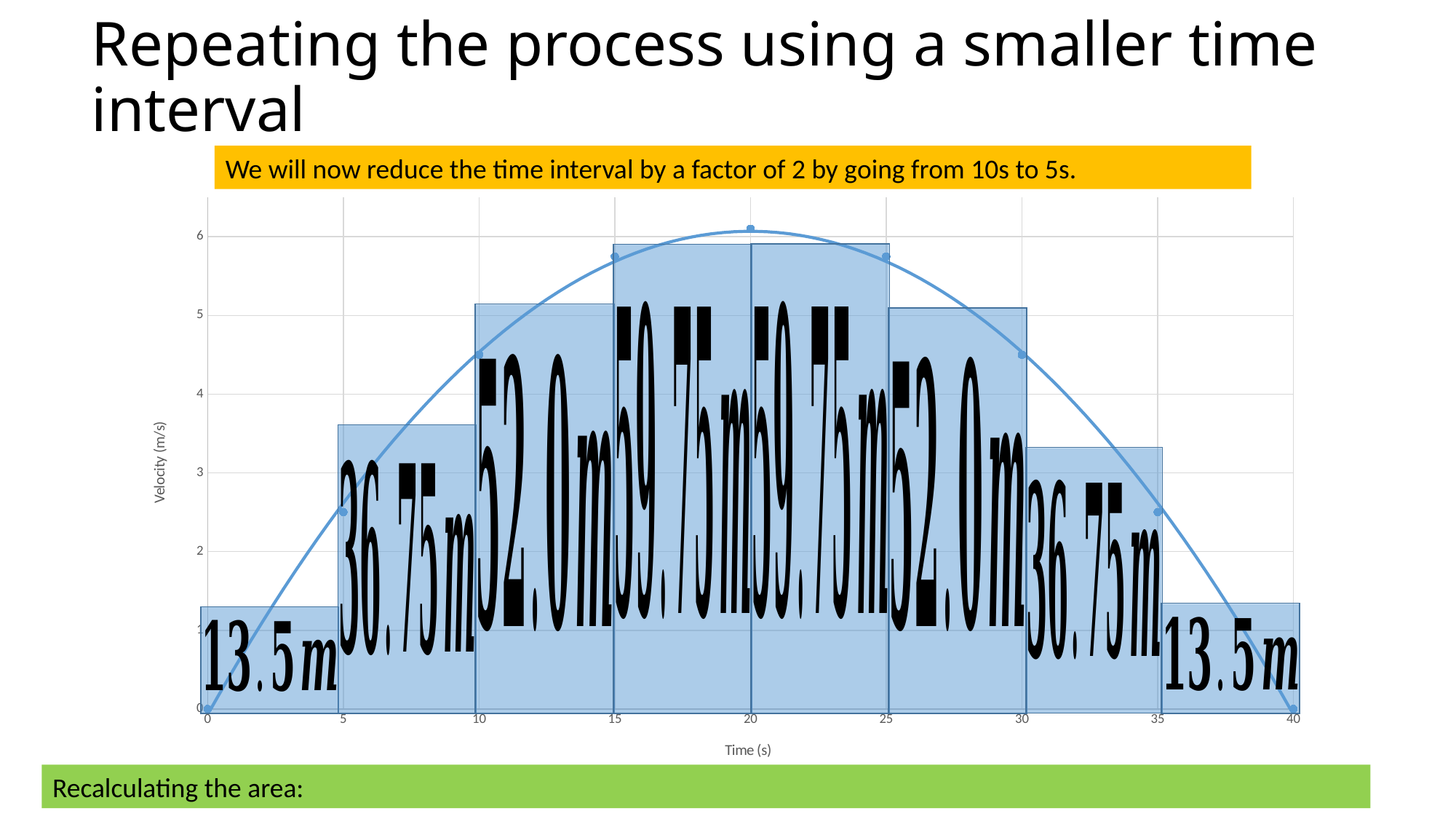
What area value is printed on the rectangle between 30 s and 35 s? 36.75m What is the difference between the area printed on the 15–20 s rectangle and the area printed on the 0–5 s rectangle? 46.25m What area value is printed on the rectangle between 0 s and 5 s? 13.5m What is the label on the y axis of the chart? Velocity (m/s) What is the smallest area value printed on any rectangle? 13.5m Is the velocity at 10 s greater or less than 4 m/s? greater What area value is printed on the rectangle between 25 s and 30 s? 52.0m Does the velocity rise or fall along the x axis between 20 s and 40 s? fall What is the label on the x axis of the chart? Time (s) What is the largest area value printed on any rectangle? 59.75m What area value is printed on the rectangle between 15 s and 20 s? 59.75m How many rectangles are drawn under the curve? 8